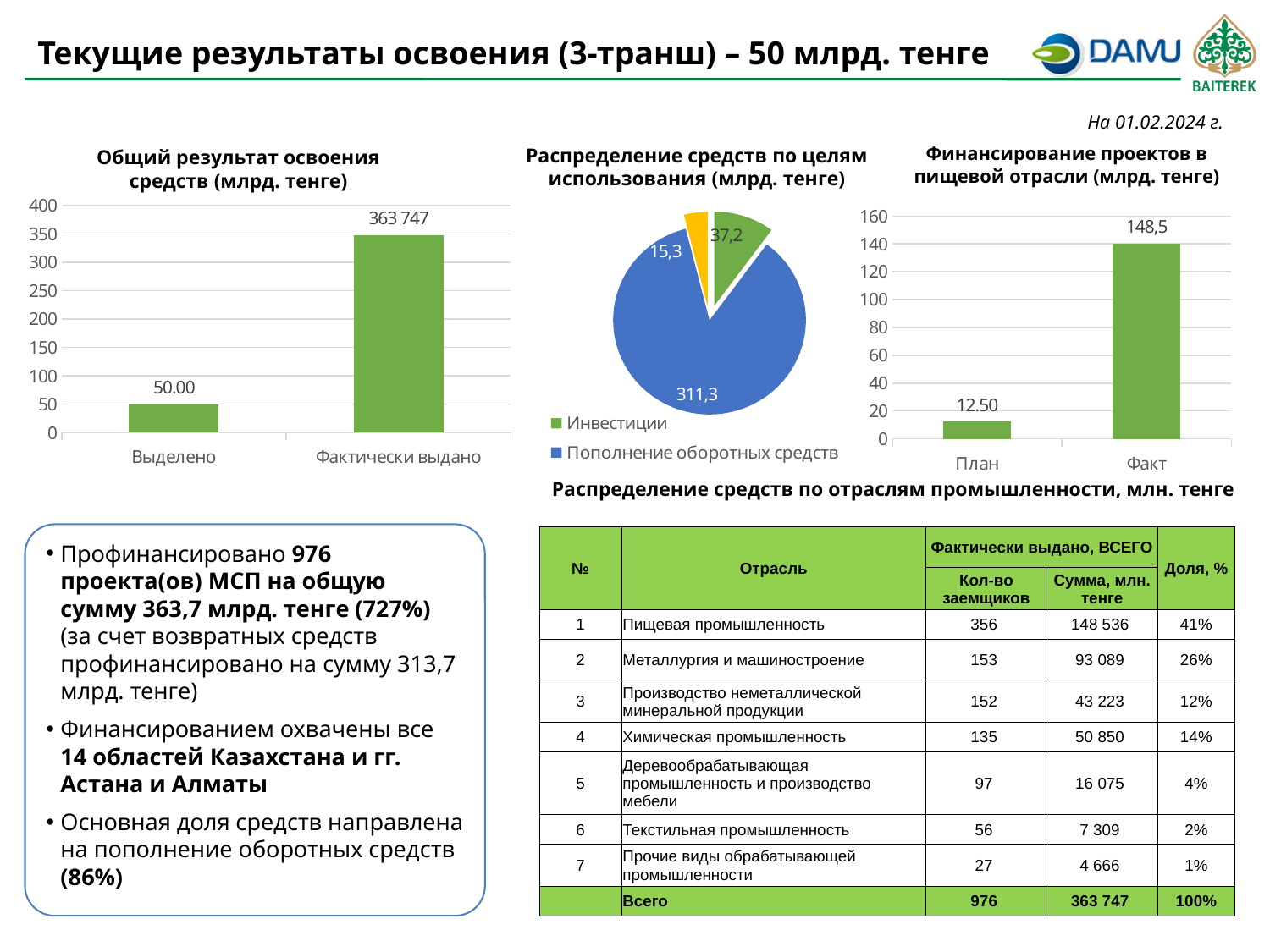
In the chart 'Финансирование проектов в пищевой отрасли (млрд. тенге)', what is the value for 'Факт'? 148,5 In the chart 'Финансирование проектов в пищевой отрасли (млрд. тенге)', is the value for 'Факт' greater or less than 140? greater What kind of chart is 'Распределение средств по целям использования (млрд. тенге)'? pie chart What kind of chart is 'Общий результат освоения средств (млрд. тенге)'? bar chart In the chart 'Финансирование проектов в пищевой отрасли (млрд. тенге)', what is the value for 'План'? 12.50 In the pie chart 'Распределение средств по целям использования (млрд. тенге)', which slice is the largest? Пополнение оборотных средств In the chart 'Общий результат освоения средств (млрд. тенге)', what is the value for 'Выделено'? 50.00 In the pie chart 'Распределение средств по целям использования (млрд. тенге)', what is the value of the 'Пополнение оборотных средств' slice? 311,3 How many entries does the legend of the pie chart 'Распределение средств по целям использования (млрд. тенге)' list? 2 In the pie chart 'Распределение средств по целям использования (млрд. тенге)', what is the value of the 'Инвестиции' slice? 37,2 In the chart 'Общий результат освоения средств (млрд. тенге)', which category has the higher bar? Фактически выдано In the chart 'Общий результат освоения средств (млрд. тенге)', what is the value for 'Фактически выдано'? 363 747